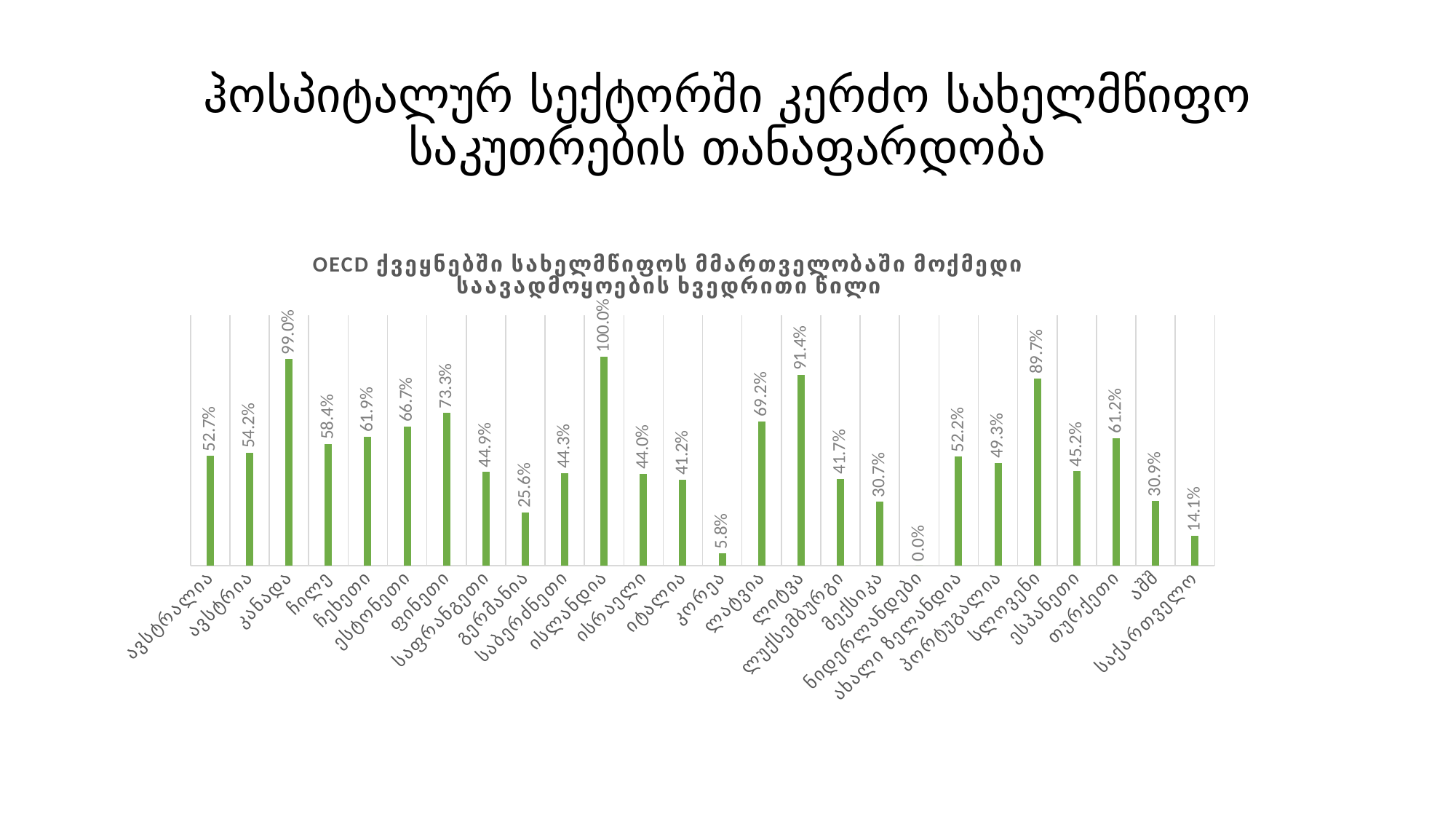
What is the difference between the values for კანადა and კორეა? 93.2% What is the value for კანადა? 99.0% What is the value for საქართველო? 14.1% What kind of chart is shown on the slide? bar chart Which is larger, the value for გერმანია or the value for მექსიკა? მექსიკა Which category has the lowest value? ნიდერლანდები How many categories are shown in the chart? 26 What is the value for ფინეთი? 73.3% Which category has the highest value? ისლანდია What is the difference between the values for ლიტვა and სლოვენია? 1.7% What colour are the bars in the chart? green What is the value for ლუქსემბურგი? 41.7%